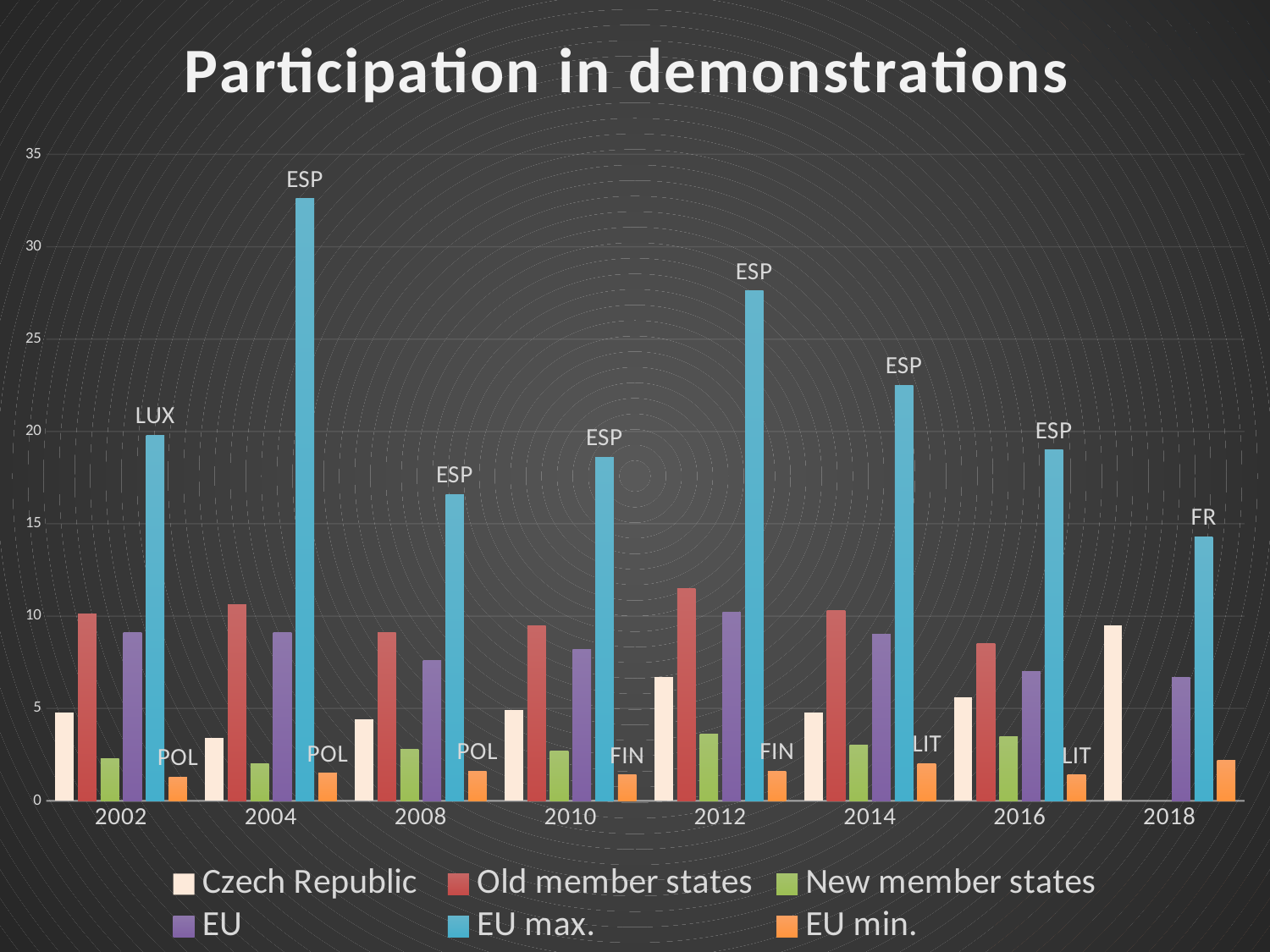
Which country label is shown on the EU max. bar for 2002? LUX What kind of chart is shown on the slide? bar chart Does the EU max. value rise or fall from 2012 to 2018? fall How many years are shown on the x axis? 8 Which country label is shown on the EU max. bar for 2018? FR How many series does the legend list? 6 In which year is the EU max. bar the lowest? 2018 Is the EU max. value for 2018 greater or less than 15? less Is the EU max. value for 2012 greater or less than 25? greater What is the title of the chart? Participation in demonstrations In which year is the EU max. bar the highest? 2004 Is the EU max. value for 2004 greater or less than 30? greater